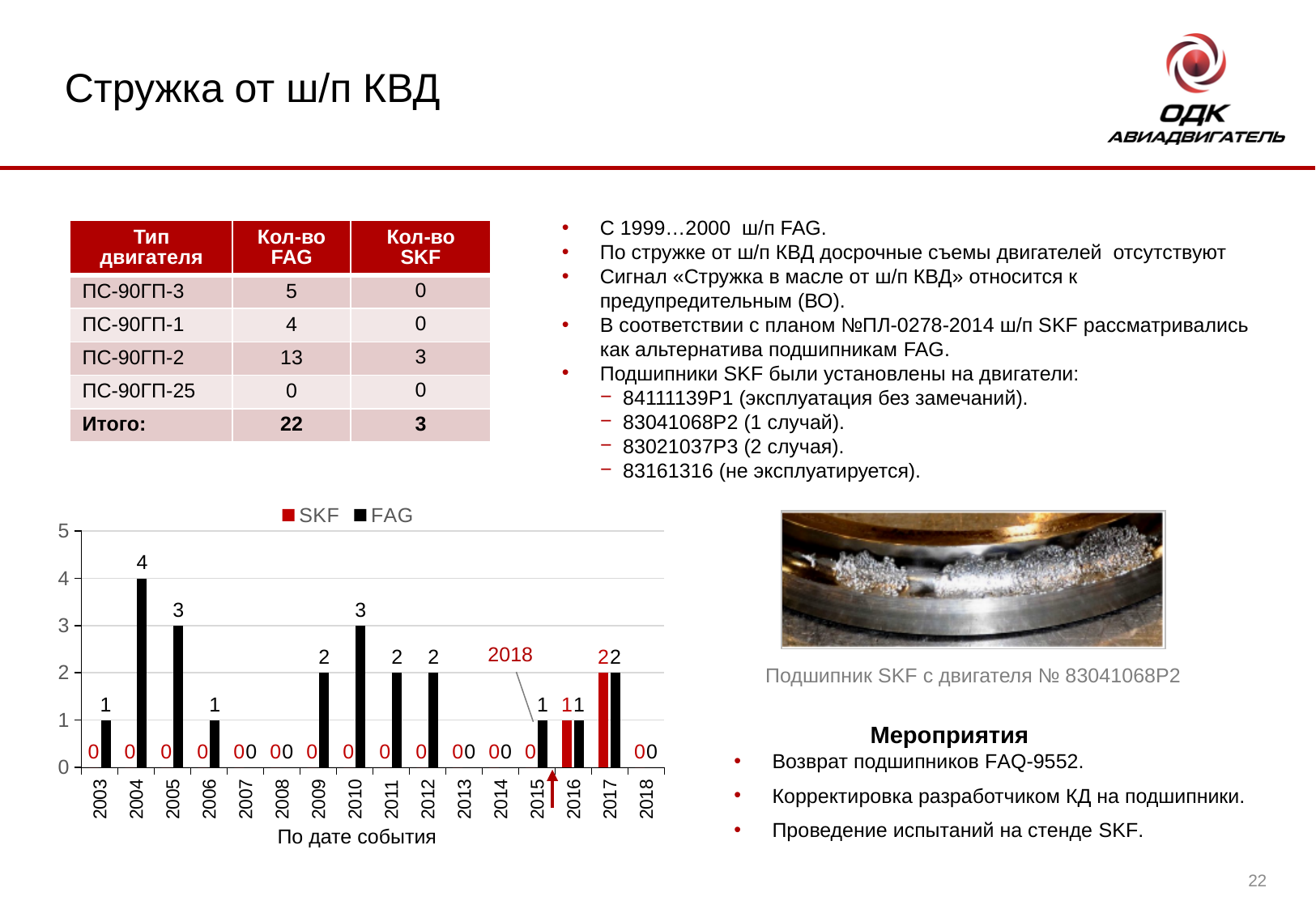
What is the SKF value for 2016? 1 What is the FAG value for 2010? 3 What is the difference between the FAG values for 2004 and 2005? 1 What is the total of the SKF and FAG values for 2017? 4 What is the SKF value for 2017? 2 What type of chart is shown on the slide? bar chart How many series does the chart legend list? 2 What is the FAG value for 2004? 4 How many years are shown on the x axis of the chart? 16 What is the x-axis title of the chart? По дате события Which year has the highest FAG value? 2004 Which is larger, the FAG value for 2009 or the FAG value for 2010? 2010